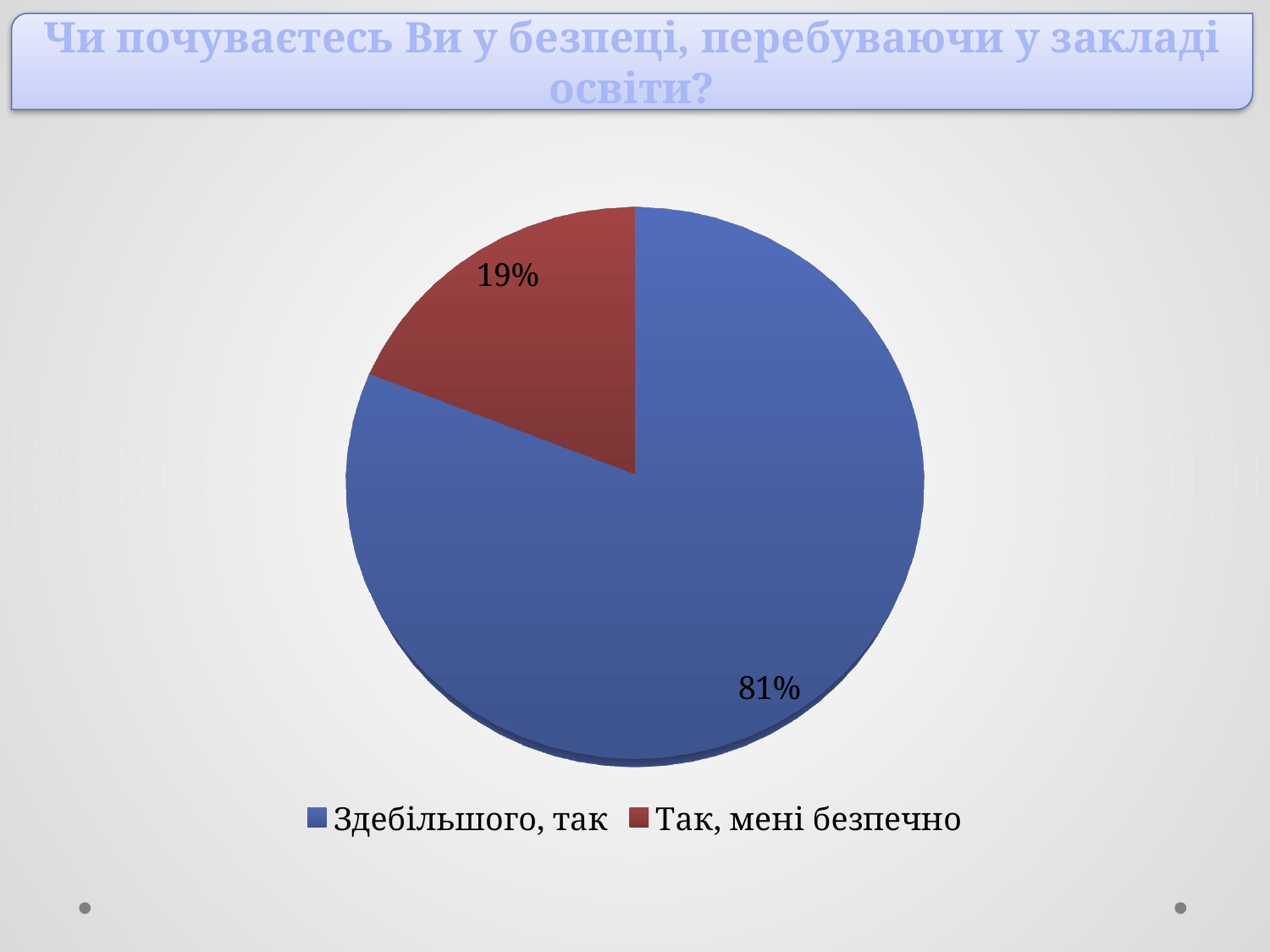
Which category has the smallest slice of the pie? Так, мені безпечно How many categories are shown in the pie chart? 2 What share of the pie does "Здебільшого, так" represent? 81% What is the difference in percentage points between the "Здебільшого, так" slice and the "Так, мені безпечно" slice? 62 What is the title of the slide? Чи почуваєтесь Ви у безпеці, перебуваючи у закладі освіти? What colour is the slice for "Так, мені безпечно"? Red Which is larger: the slice for "Здебільшого, так" or the slice for "Так, мені безпечно"? Здебільшого, так How many entries does the legend list? 2 Which category has the largest slice of the pie? Здебільшого, так What kind of chart is shown on the slide? Pie chart What share of the pie does "Так, мені безпечно" represent? 19%